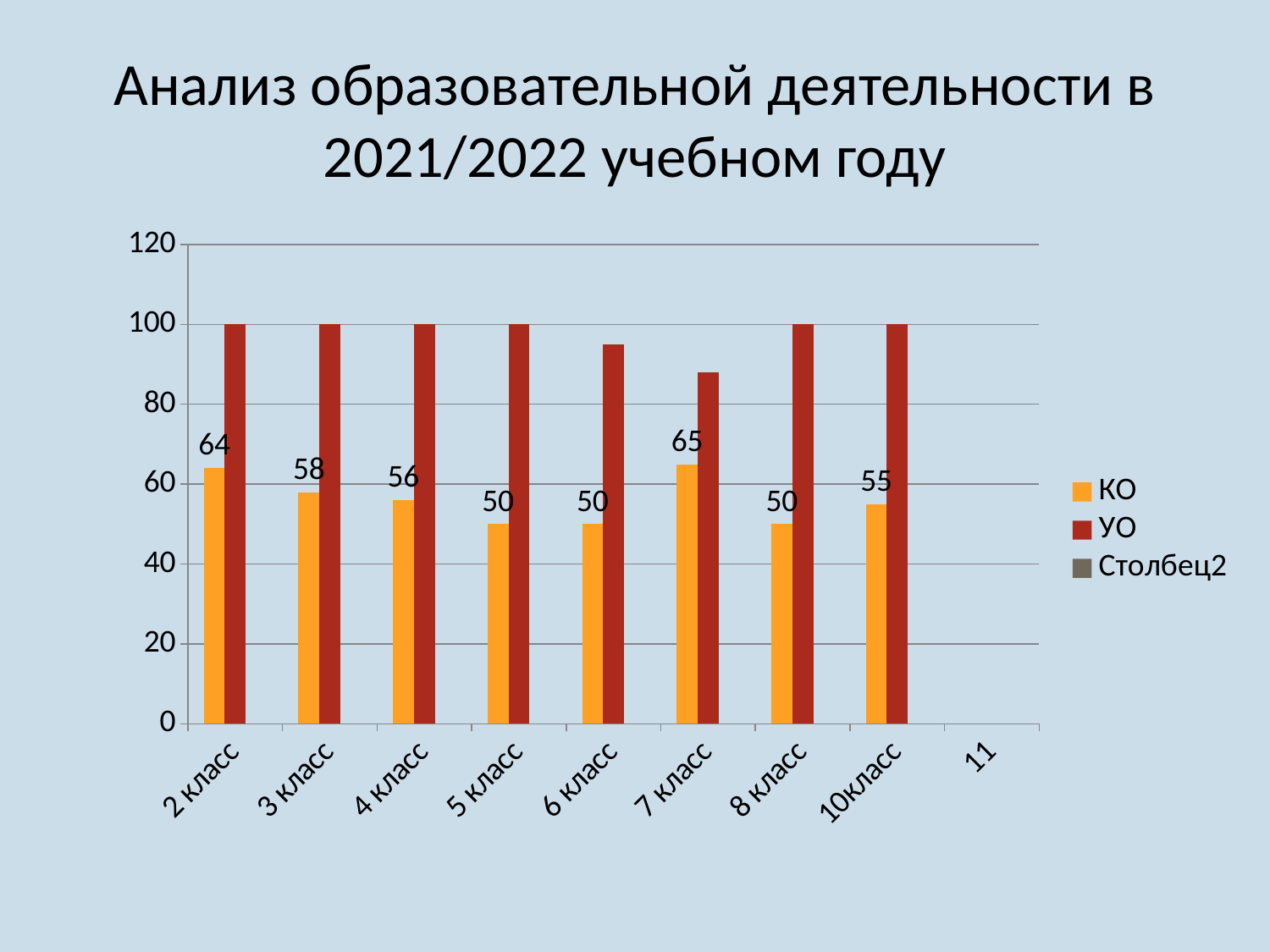
What is the КО value for 2 класс? 64 Which is larger, the КО value for 3 класс or for 4 класс? 3 класс What is the УО value for 3 класс? 100 How many series does the legend list? 3 Which category has the highest КО value? 7 класс What is the КО value for 7 класс? 65 What is the difference between the КО values for 2 класс and 5 класс? 14 What type of chart is shown on the slide? bar chart Is the УО value for 7 класс greater or less than 80? greater Is the УО value for 6 класс greater or less than 100? less What is the КО value for 10класс? 55 What colour are the bars for the УО series? dark red